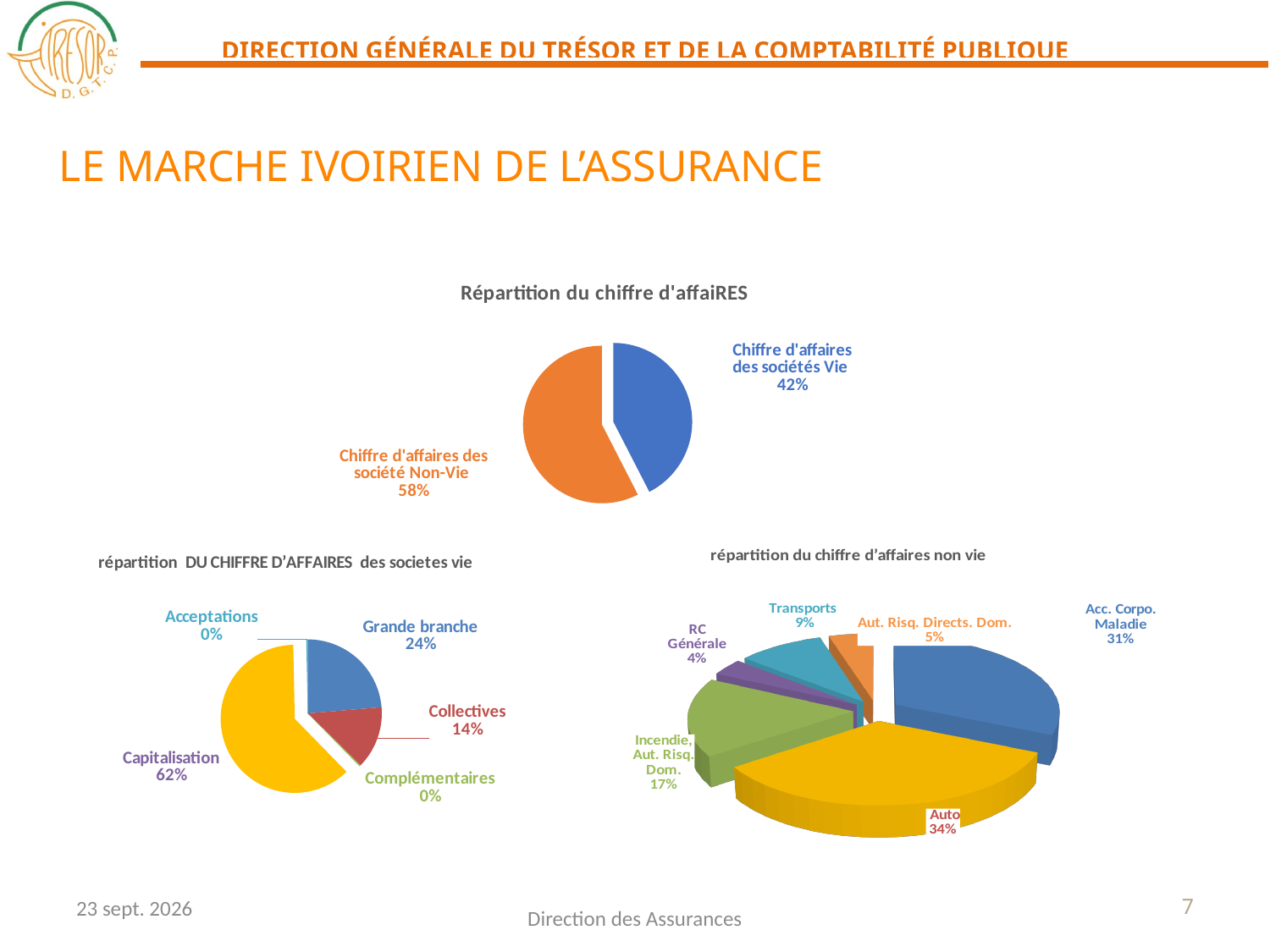
In the bottom-right chart 'répartition du chiffre d'affaires non vie', which category has the smallest share? RC Générale In the bottom-left chart 'répartition DU CHIFFRE D'AFFAIRES des societes vie', what share is 'Collectives'? 14% In the bottom-right chart 'répartition du chiffre d'affaires non vie', what share is 'Acc. Corpo. Maladie'? 31% In the bottom-right chart 'répartition du chiffre d'affaires non vie', which is larger: 'Transports' or 'Incendie, Aut. Risq. Dom.'? Incendie, Aut. Risq. Dom. In the top chart 'Répartition du chiffre d'affaiRES', what is the difference between the Non-Vie share and the Vie share? 16% In the bottom-right chart 'répartition du chiffre d'affaires non vie', which category has the largest share? Auto In the top chart 'Répartition du chiffre d'affaiRES', what share is 'Chiffre d'affaires des sociétés Vie'? 42% In the bottom-left chart 'répartition DU CHIFFRE D'AFFAIRES des societes vie', which category has the largest share? Capitalisation How many categories are shown in the bottom-left chart 'répartition DU CHIFFRE D'AFFAIRES des societes vie'? 5 What kind of chart is the top chart 'Répartition du chiffre d'affaiRES'? Pie chart